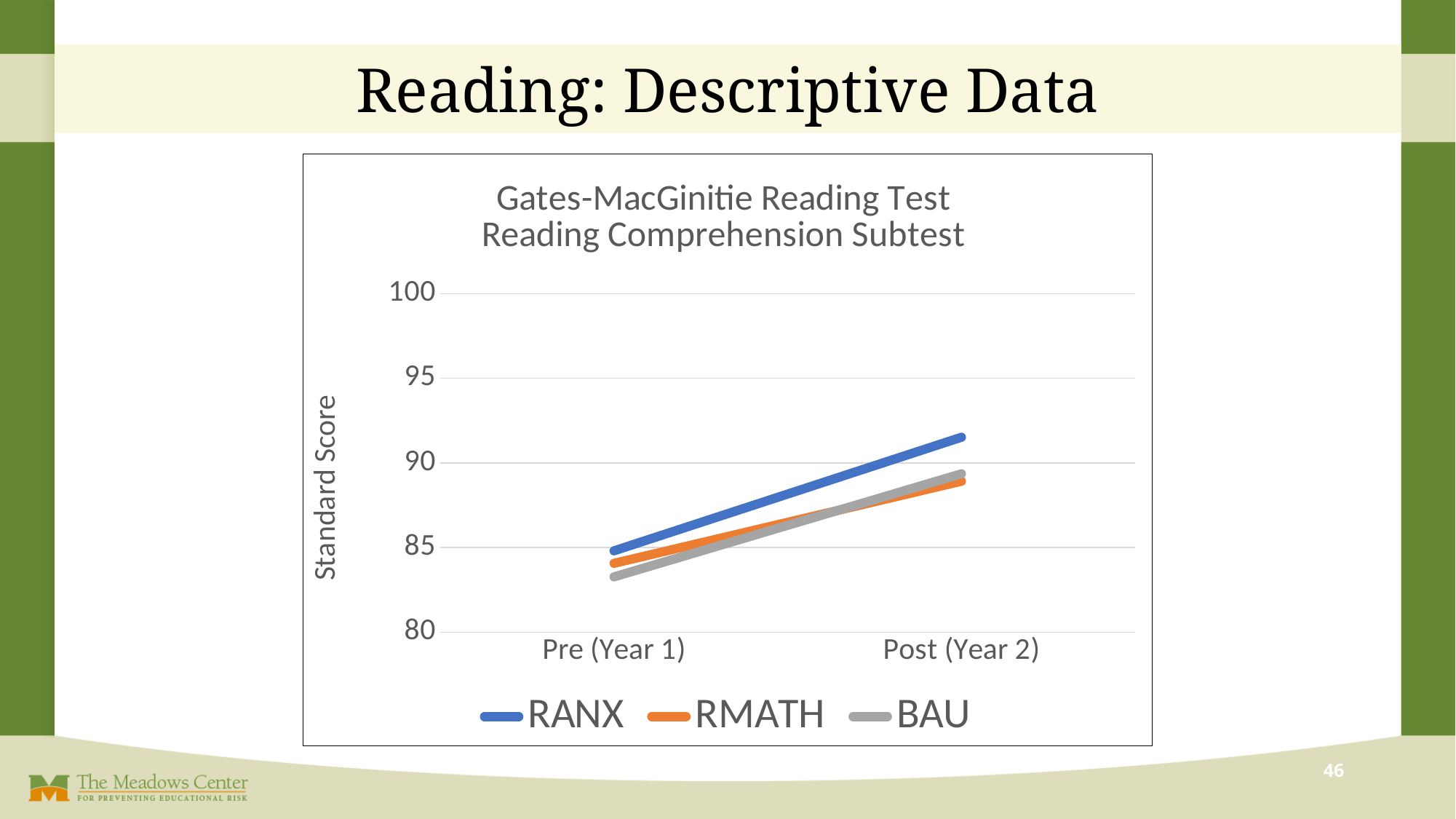
How many series does the legend list? 3 Which series has the lowest value at Pre (Year 1)? BAU How many points are on the x axis? 2 Is the value for BAU at Pre (Year 1) greater or less than 85? less Which series has the highest value at Post (Year 2)? RANX Do the RANX values rise or fall from Pre (Year 1) to Post (Year 2)? Rise What is the title of the chart? Gates-MacGinitie Reading Test Reading Comprehension Subtest Is the value for RMATH at Post (Year 2) greater or less than 90? less What is the label of the y axis? Standard Score Is the value for RANX at Post (Year 2) greater or less than 90? greater At Post (Year 2), which is larger, RANX or RMATH? RANX What kind of chart is shown on the slide? Line chart